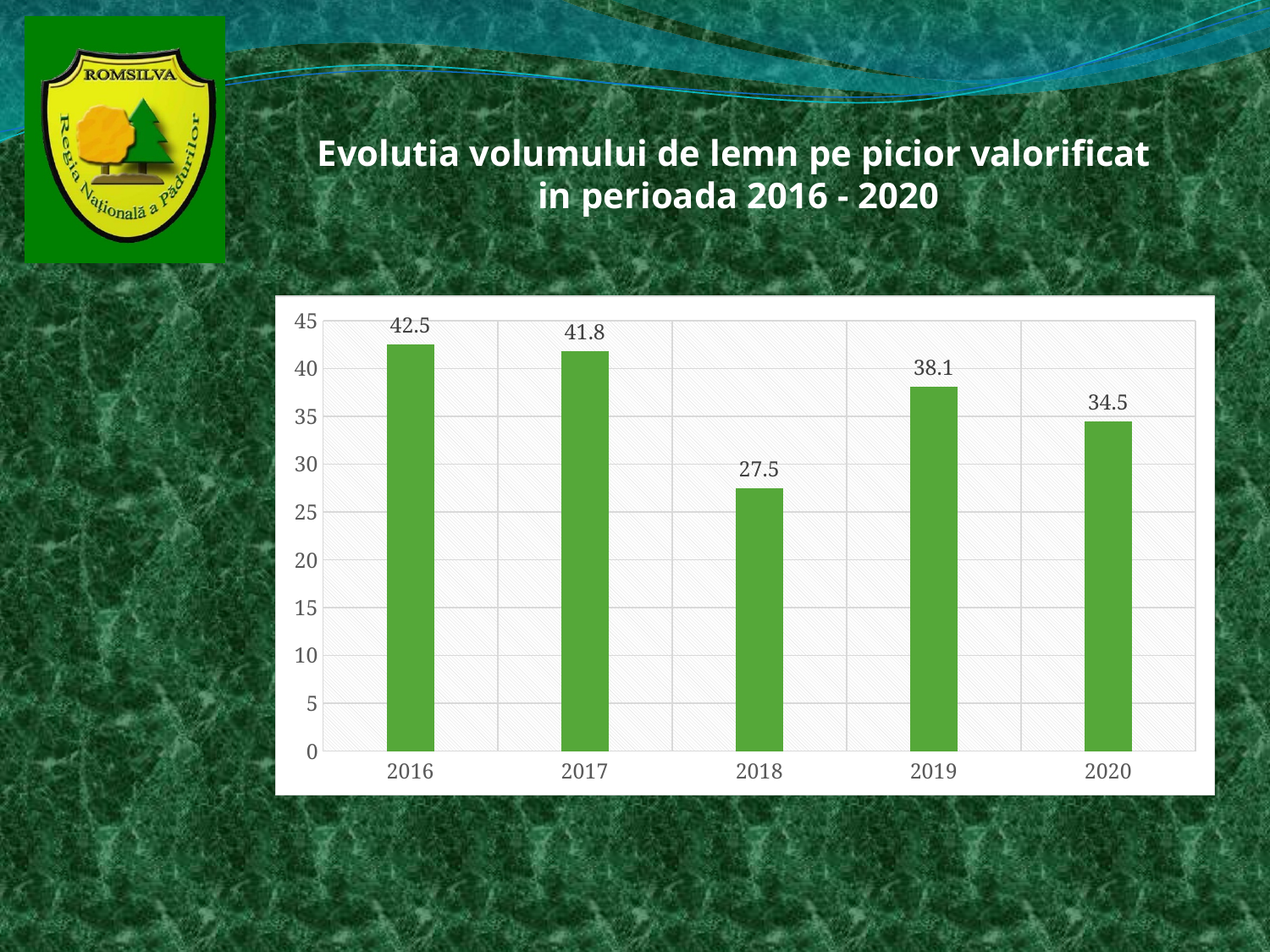
What kind of chart is shown on the slide? bar chart Which is larger, the value for 2017 or the value for 2019? 2017 What is the difference between the values for 2019 and 2020? 3.6 What is the value for 2020? 34.5 What is the value for 2016? 42.5 What is the title of the slide above the chart? Evolutia volumului de lemn pe picior valorificat in perioada 2016 - 2020 What is the difference between the values for 2016 and 2018? 15 Is the value for 2019 greater or less than 35? greater Which year has the highest value? 2016 What is the value for 2018? 27.5 How many years are shown on the x axis? 5 Which year has the lowest value? 2018